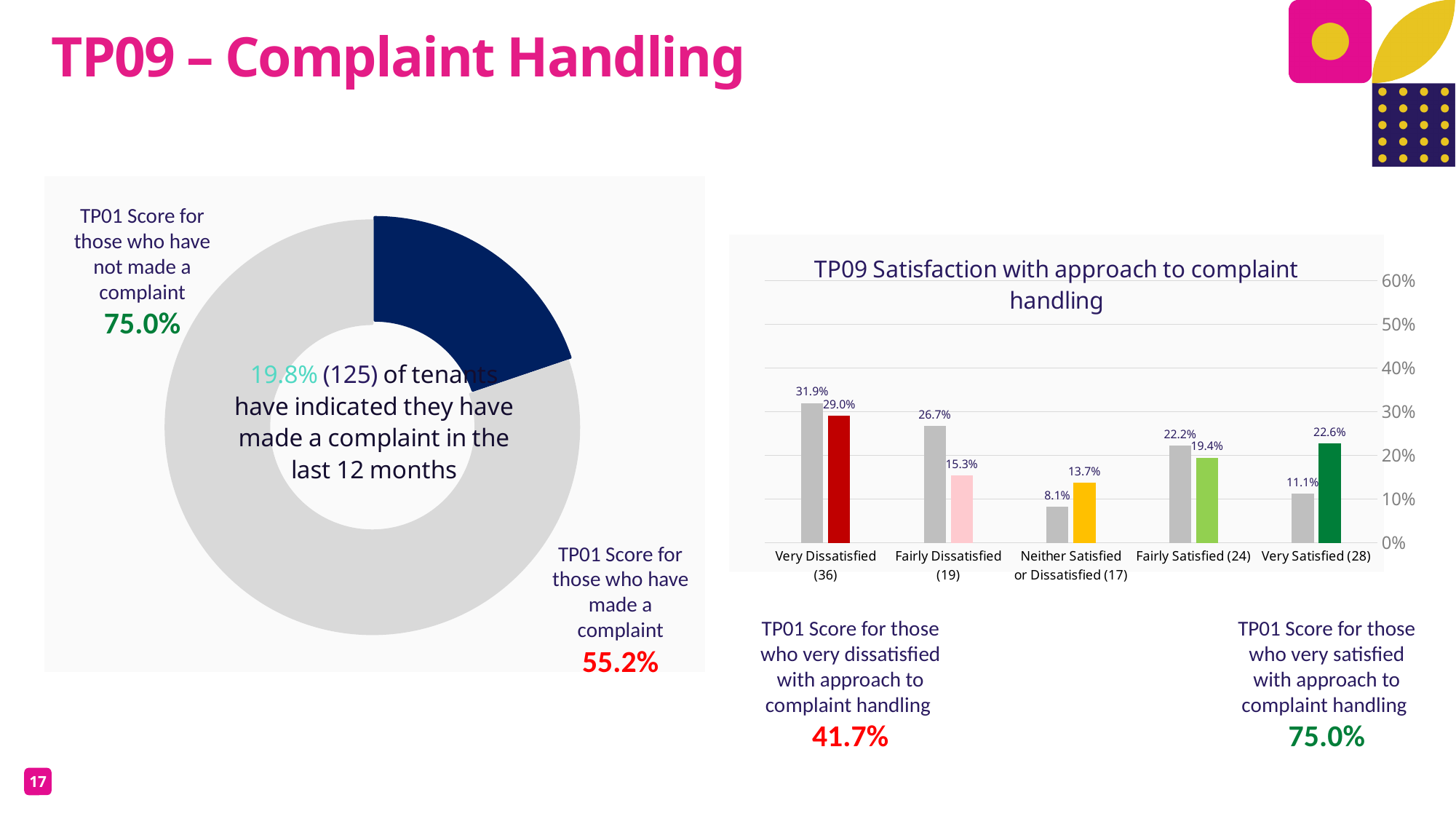
In the bar chart titled 'TP09 Satisfaction with approach to complaint handling', what is the difference between the grey bar and the coloured bar for Fairly Dissatisfied (19)? 11.4% In the bar chart titled 'TP09 Satisfaction with approach to complaint handling', which is larger for Very Satisfied (28): the grey bar or the green bar? The green bar In the bar chart titled 'TP09 Satisfaction with approach to complaint handling', what is the value of the grey bar for Very Dissatisfied (36)? 31.9% In the bar chart titled 'TP09 Satisfaction with approach to complaint handling', which category has the lowest coloured bar? Neither Satisfied or Dissatisfied (17) In the bar chart titled 'TP09 Satisfaction with approach to complaint handling', which category has the highest grey bar? Very Dissatisfied (36) In the bar chart titled 'TP09 Satisfaction with approach to complaint handling', is the grey bar for Fairly Satisfied (24) greater or less than 20%? greater In the donut chart on the left, what percentage of tenants have indicated they have made a complaint in the last 12 months? 19.8% In the bar chart titled 'TP09 Satisfaction with approach to complaint handling', what is the value of the coloured (red) bar for Very Dissatisfied (36)? 29.0% In the bar chart titled 'TP09 Satisfaction with approach to complaint handling', what is the value of the grey bar for Neither Satisfied or Dissatisfied (17)? 8.1% In the bar chart titled 'TP09 Satisfaction with approach to complaint handling', what is the value of the green bar for Very Satisfied (28)? 22.6% What kind of chart is the chart on the left of the slide? Donut (pie) chart How many categories are shown on the x axis of the bar chart titled 'TP09 Satisfaction with approach to complaint handling'? 5